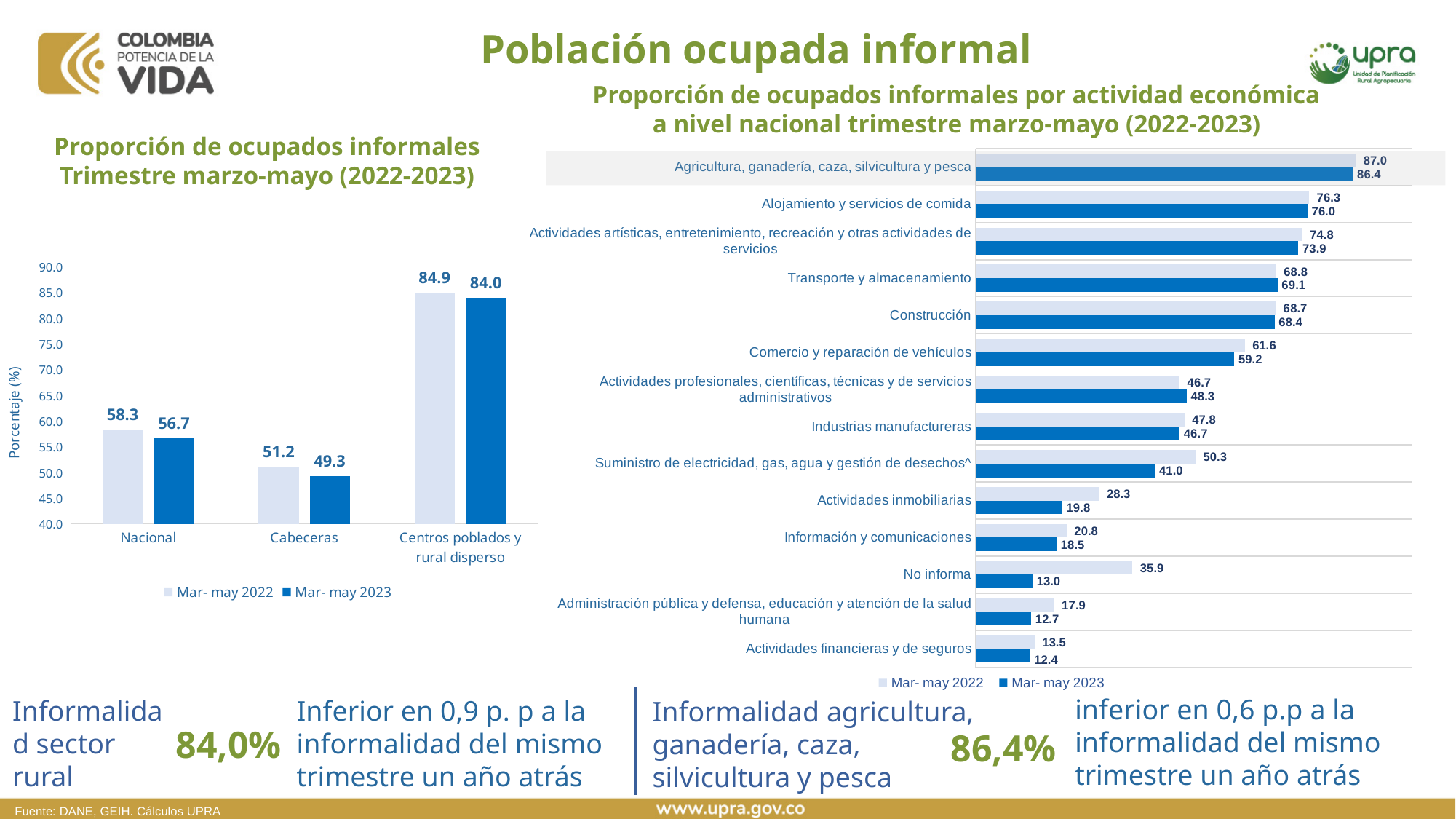
In the right chart (Proporción de ocupados informales por actividad económica), what is the Mar- may 2023 value for Agricultura, ganadería, caza, silvicultura y pesca? 86.4 In the left chart (Proporción de ocupados informales Trimestre marzo-mayo), what is the value for Cabeceras in Mar- may 2022? 51.2 In the right chart (Proporción de ocupados informales por actividad económica), how many series does the legend list? 2 In the left chart (Proporción de ocupados informales Trimestre marzo-mayo), what type of chart is used? Bar chart In the left chart (Proporción de ocupados informales Trimestre marzo-mayo), which category has the highest value in Mar- may 2023? Centros poblados y rural disperso In the right chart (Proporción de ocupados informales por actividad económica), which is larger for Transporte y almacenamiento: the Mar- may 2022 value or the Mar- may 2023 value? Mar- may 2023 In the left chart (Proporción de ocupados informales Trimestre marzo-mayo), what is the value for Nacional in Mar- may 2023? 56.7 In the left chart (Proporción de ocupados informales Trimestre marzo-mayo), how many categories are shown on the x axis? 3 In the right chart (Proporción de ocupados informales por actividad económica), what is the Mar- may 2022 value for No informa? 35.9 In the right chart (Proporción de ocupados informales por actividad económica), which activity has the lowest Mar- may 2023 value? Actividades financieras y de seguros In the right chart (Proporción de ocupados informales por actividad económica), what is the difference between the Mar- may 2022 and Mar- may 2023 values for Suministro de electricidad, gas, agua y gestión de desechos^? 9.3 In the left chart (Proporción de ocupados informales Trimestre marzo-mayo), what is the difference between the Mar- may 2022 and Mar- may 2023 values for Centros poblados y rural disperso? 0.9